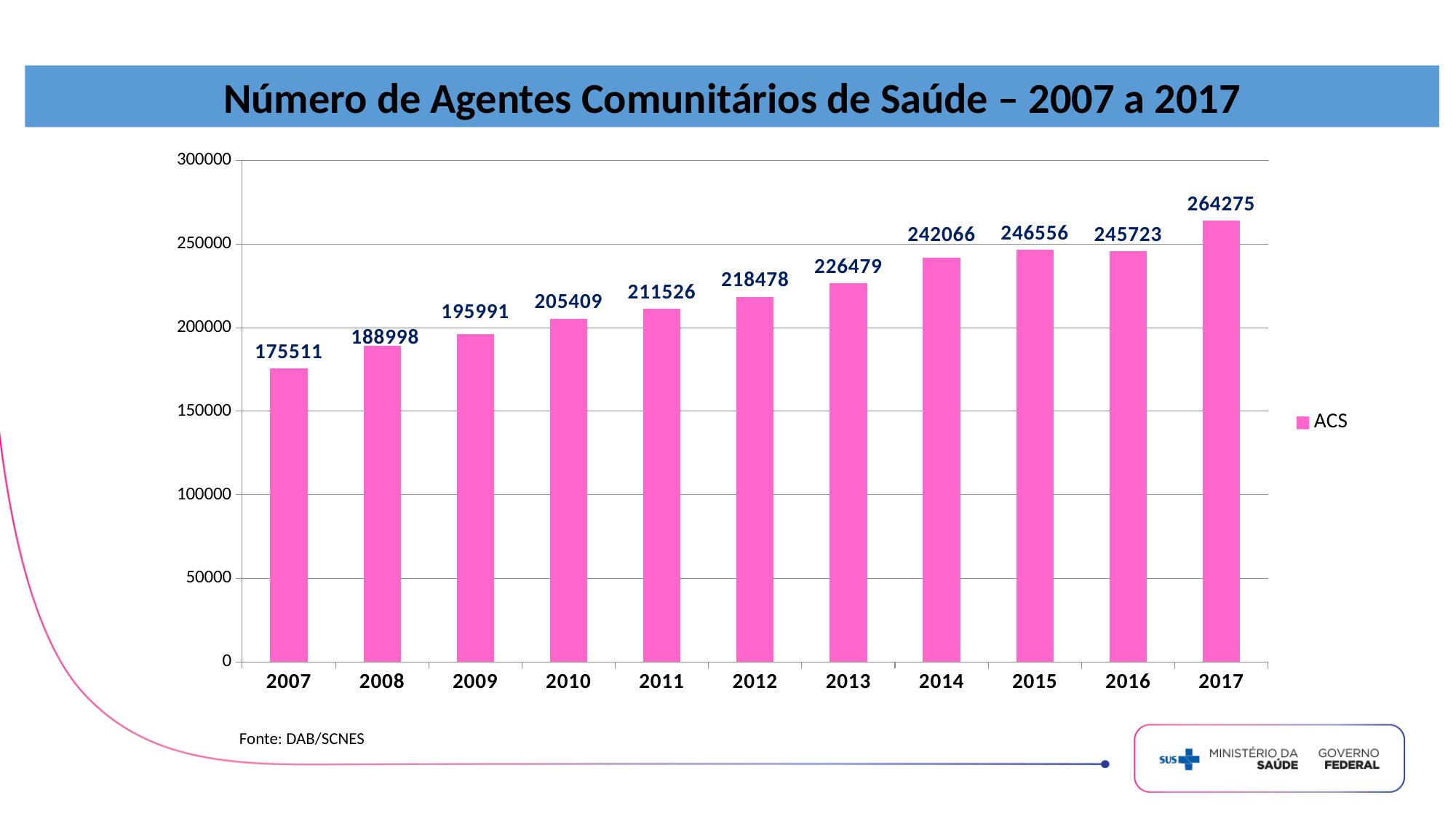
What is the value for 2016? 245723 What is the value for 2007? 175511 What is the value for 2013? 226479 Is the value for 2014 greater or less than 200000? greater Which year has the highest value? 2017 Which is larger, the value for 2010 or the value for 2012? 2012 What is the difference between the values for 2017 and 2007? 88764 What series name does the legend show? ACS What is the difference between the values for 2015 and 2016? 833 How many years are shown on the x axis? 11 What kind of chart is shown on the slide? bar chart Which year has the lowest value? 2007